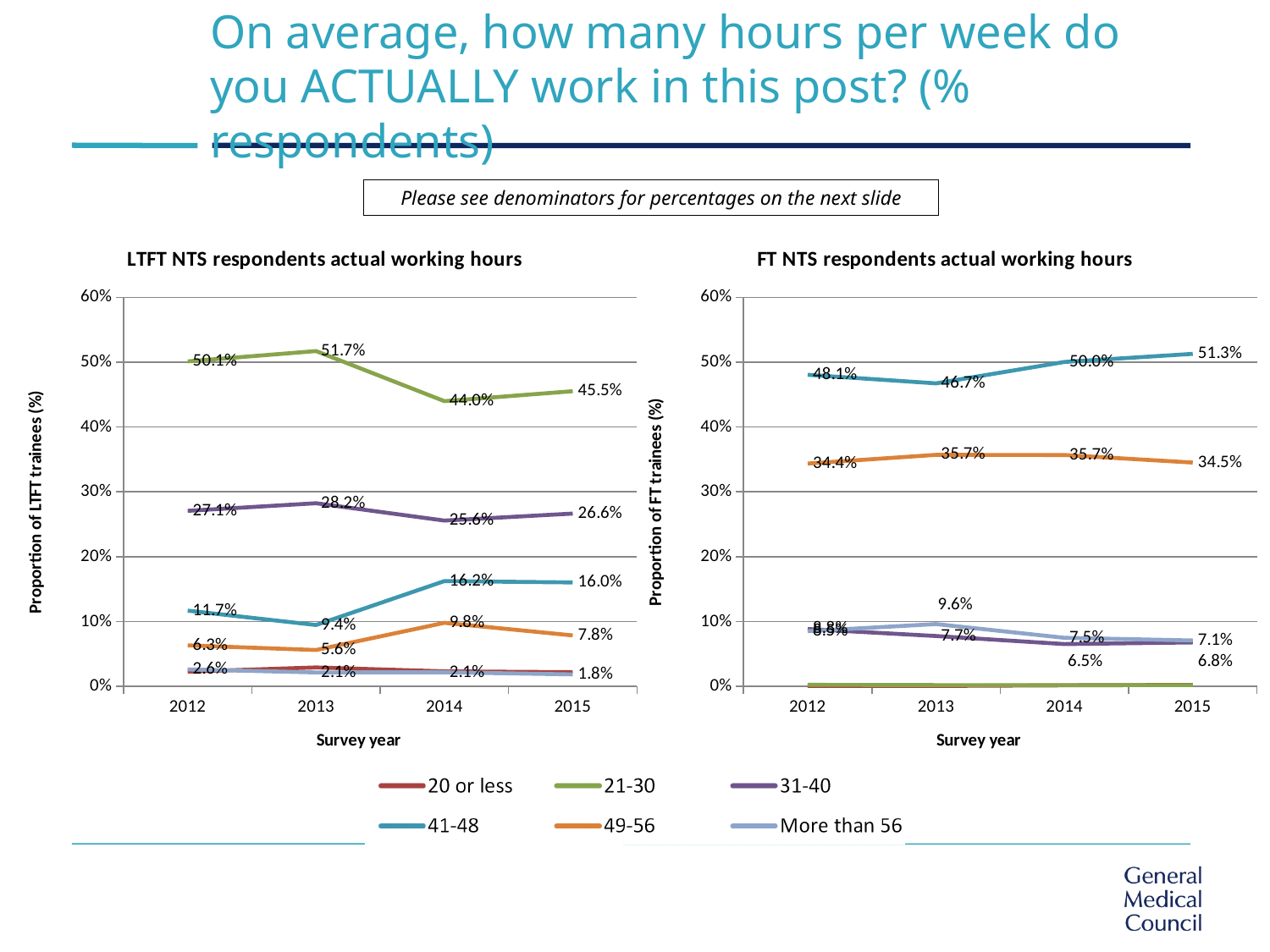
In the FT NTS respondents actual working hours chart, what is the value for the 49-56 hours series in 2012? 34.4% In the LTFT NTS respondents actual working hours chart, what is the value for the 21-30 hours series in 2013? 51.7% What type of chart is used for the LTFT NTS respondents actual working hours chart? Line chart How many series does the shared legend list for the two charts? 6 How many survey years are plotted on the x axis of the FT NTS respondents actual working hours chart? 4 In the FT NTS respondents actual working hours chart, does the 41-48 hours series rise or fall from 2013 to 2015? Rise In the LTFT NTS respondents actual working hours chart, in which survey year is the 21-30 hours series highest? 2013 What is the y-axis label of the LTFT NTS respondents actual working hours chart? Proportion of LTFT trainees (%) In the FT NTS respondents actual working hours chart, what is the value for the 41-48 hours series in 2015? 51.3% In the LTFT NTS respondents actual working hours chart, what is the value for the 31-40 hours series in 2014? 25.6% In the LTFT NTS respondents actual working hours chart, which series has the larger value in 2014: 41-48 or 49-56? 41-48 In the FT NTS respondents actual working hours chart, by how many percentage points did the 41-48 hours series change from 2012 to 2015? 3.2 percentage points